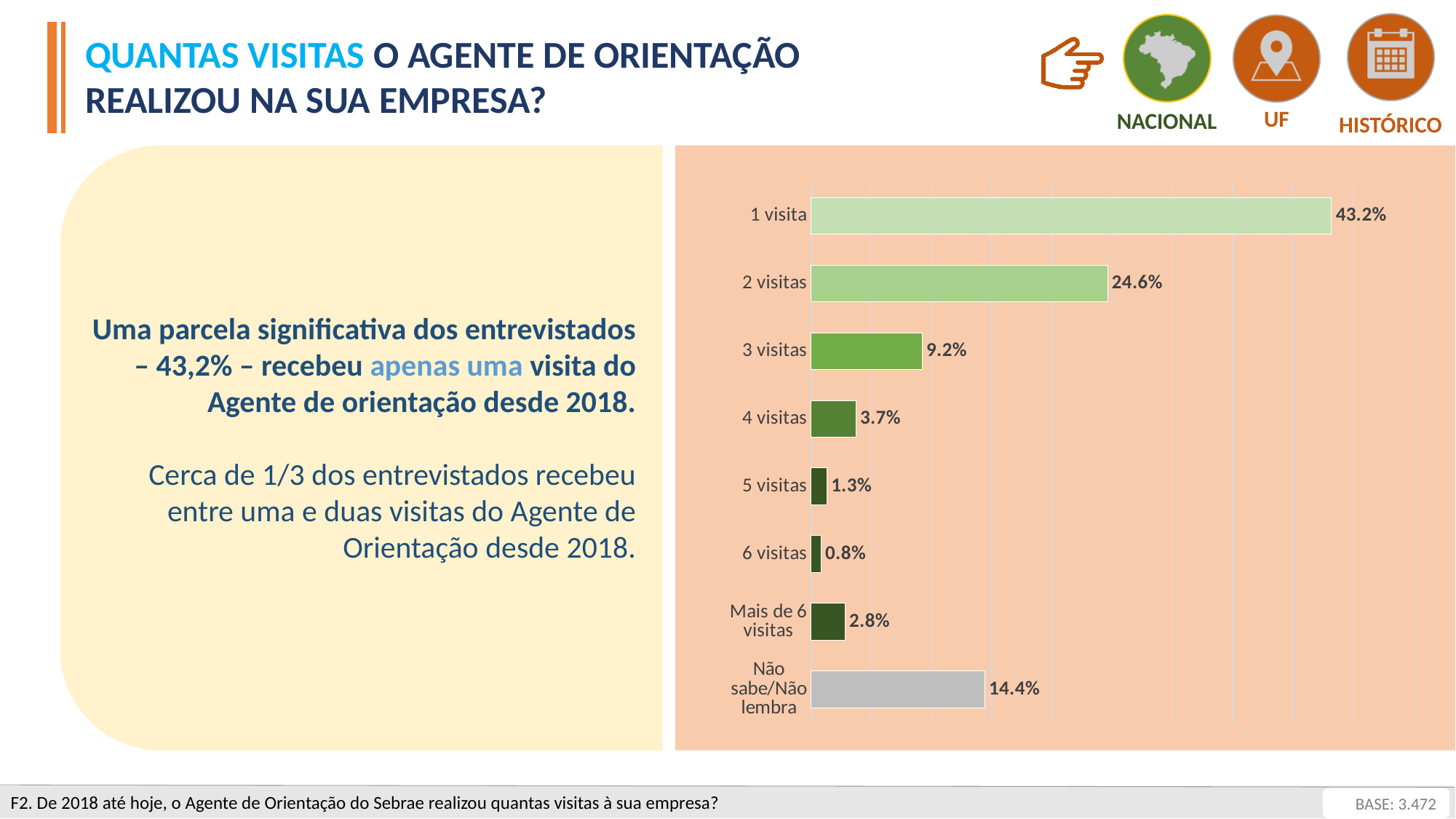
How many categories are shown in the chart? 8 What is the value for "Mais de 6 visitas"? 2.8% Which category has the highest value? 1 visita What is the value for "2 visitas"? 24.6% What kind of chart is shown on the slide? Bar chart Which category has the lowest value? 6 visitas Which is larger, the value for "3 visitas" or the value for "Não sabe/Não lembra"? Não sabe/Não lembra What is the difference between the values for "1 visita" and "2 visitas"? 18.6% What is the difference between the values for "4 visitas" and "5 visitas"? 2.4% What is the value for "1 visita"? 43.2% What colour is the bar for "Não sabe/Não lembra"? Grey What is the value for "Não sabe/Não lembra"? 14.4%